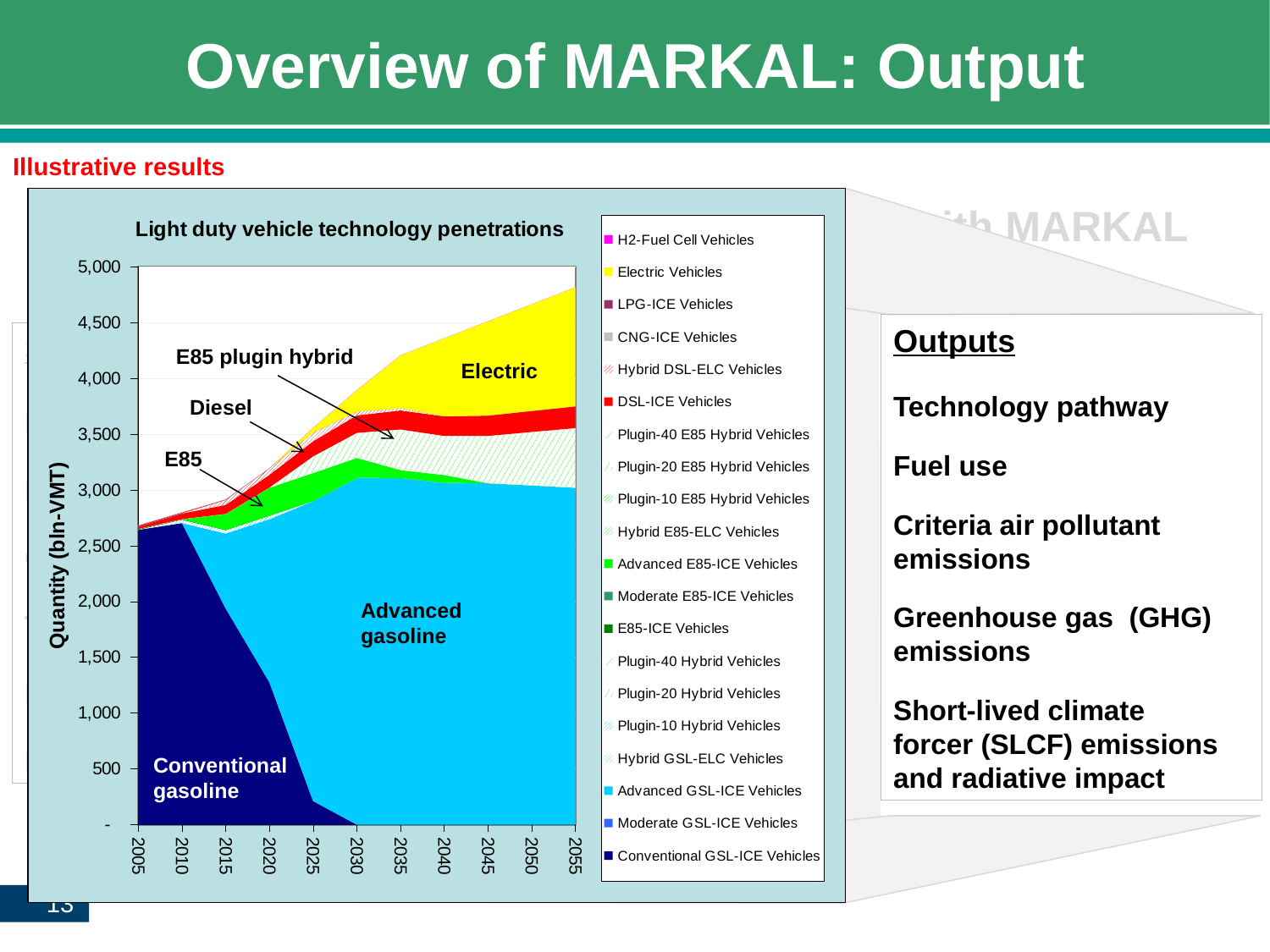
What is the title of the chart? Light duty vehicle technology penetrations How many series does the chart's legend list? 20 Does the Conventional gasoline area rise or fall from 2005 to 2030? Falls Is the total quantity in 2055 greater or less than 4,500? greater Does the total quantity across all vehicle technologies rise or fall from 2005 to 2055? Rises What kind of chart is shown on the slide? Stacked area chart What is the first year shown on the x axis of the chart? 2005 What is the highest value marked on the vertical axis of the chart? 5,000 What is the label of the vertical axis of the chart? Quantity (bln-VMT) Is the total quantity in 2005 greater or less than 3,000? less What is the last year shown on the x axis of the chart? 2055 How many years are marked along the x axis of the chart? 11